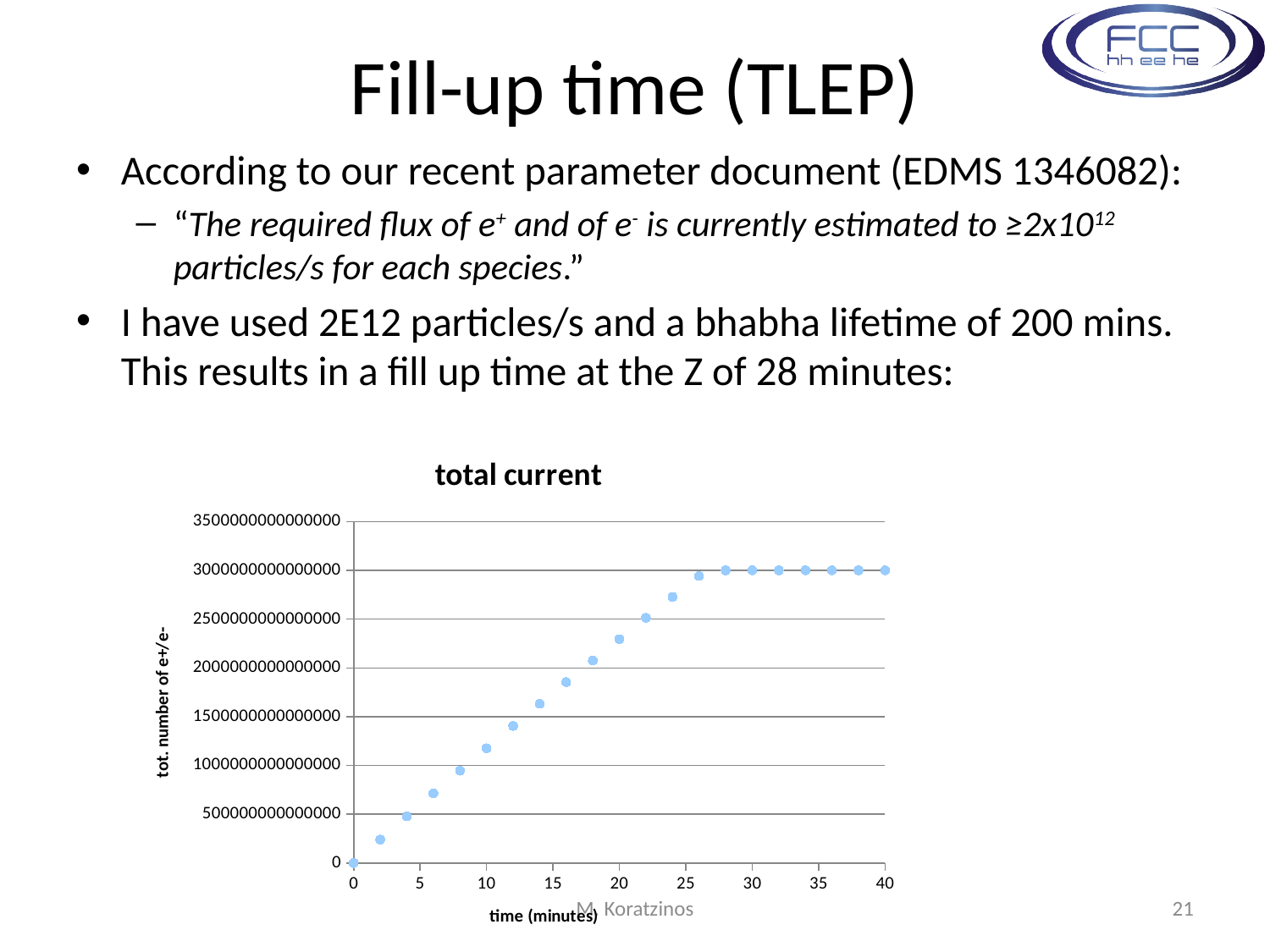
What is the title of the chart? total current How do the values change as time increases from 0 to 40 minutes? rise, then level off Is the value at 10 minutes greater or less than 1000000000000000? greater Which is larger, the value at 10 minutes or the value at 20 minutes? 20 minutes At which time (in minutes) is the plotted value lowest? 0 What is the plotted value at time 0 minutes? 0 What is the label of the x axis of the chart? time (minutes) What kind of chart is shown on the slide? scatter chart How many data points are plotted in the chart? 21 Is the value at 30 minutes greater or less than 3500000000000000? less Is the value at 20 minutes greater or less than 2000000000000000? greater